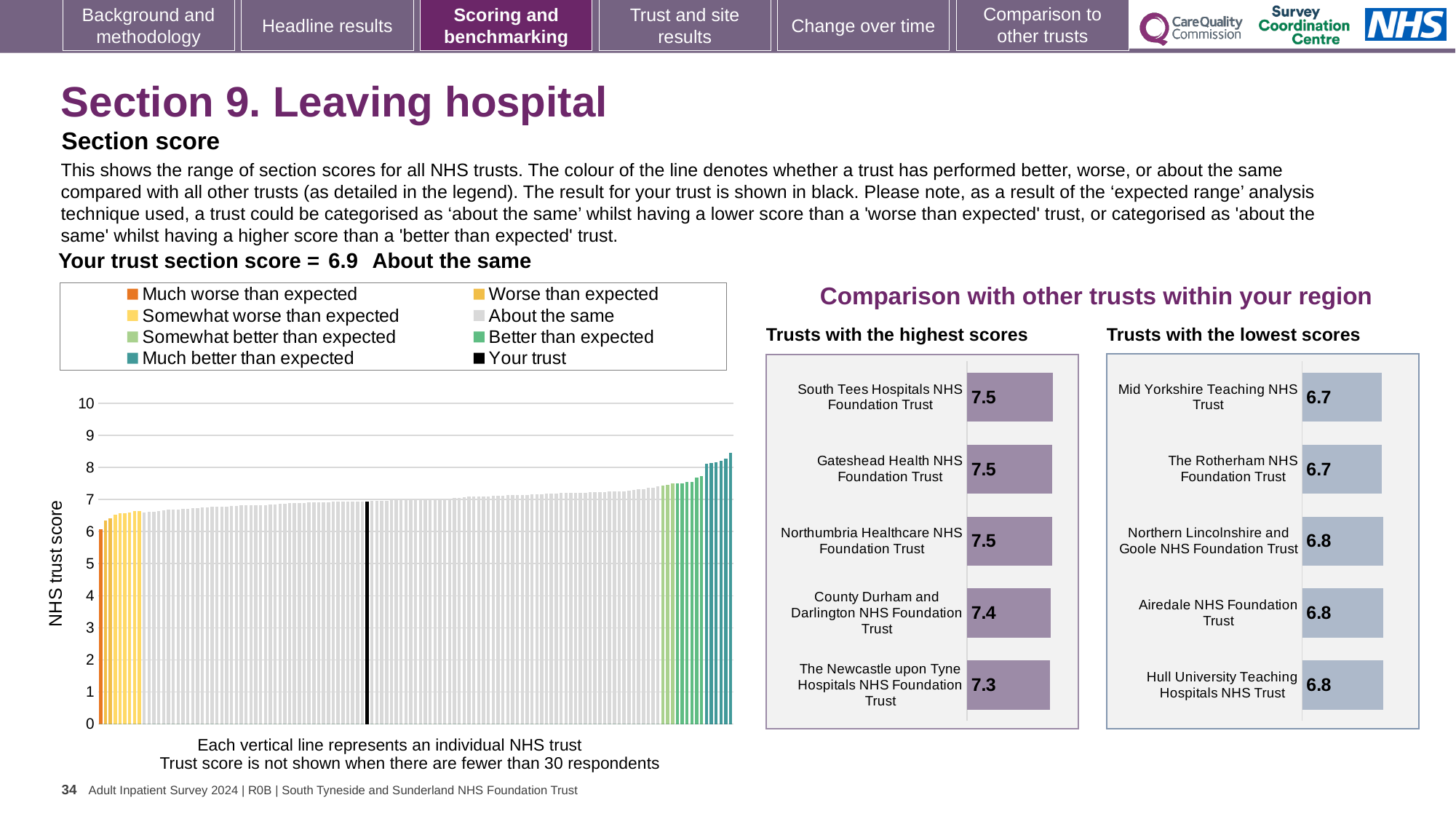
How many entries does the legend above the large chart on the left list? 8 In the 'Trusts with the highest scores' chart, which has the higher score: County Durham and Darlington NHS Foundation Trust or The Newcastle upon Tyne Hospitals NHS Foundation Trust? County Durham and Darlington NHS Foundation Trust In the 'Trusts with the highest scores' chart, what is the difference between the scores of South Tees Hospitals NHS Foundation Trust and The Newcastle upon Tyne Hospitals NHS Foundation Trust? 0.2 What kind of chart is the large chart on the left showing NHS trust scores? Bar chart How many trusts are shown in the 'Trusts with the highest scores' chart? 5 In the large chart on the left, do the NHS trust scores rise or fall from left to right? Rise In the 'Trusts with the highest scores' chart, what is the score for South Tees Hospitals NHS Foundation Trust? 7.5 In the large chart on the left, is the value of the black 'Your trust' bar greater or less than 5? greater What is the label on the vertical axis of the large chart on the left? NHS trust score In the 'Trusts with the lowest scores' chart, what is the score for Hull University Teaching Hospitals NHS Trust? 6.8 How many trusts are shown in the 'Trusts with the lowest scores' chart? 5 In the 'Trusts with the highest scores' chart, which trust has the lowest score? The Newcastle upon Tyne Hospitals NHS Foundation Trust